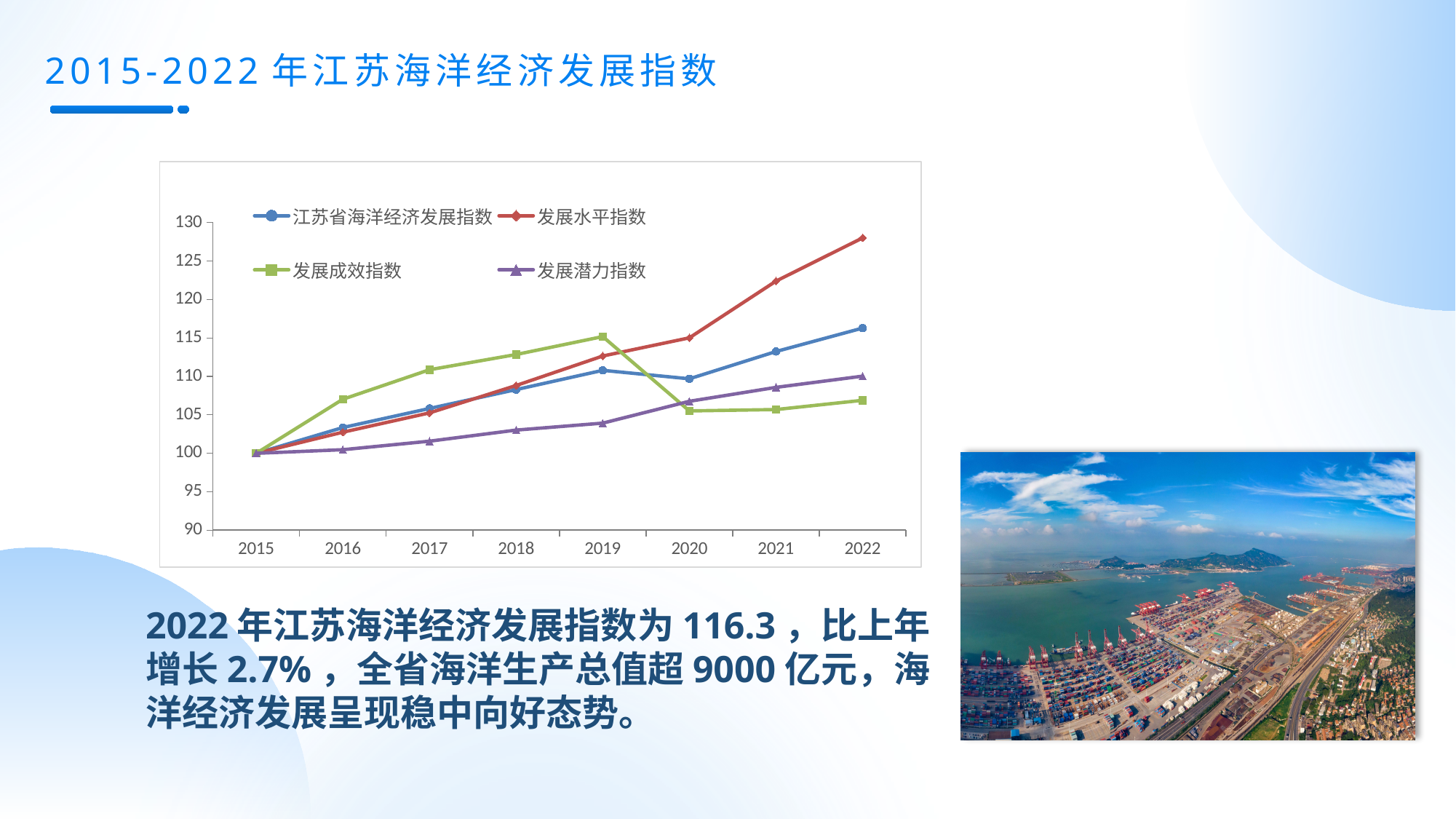
What is the value of all four indices in 2015? 100 In 2019, which is larger: 发展成效指数 or 发展水平指数? 发展成效指数 Is the value of 发展水平指数 in 2022 greater or less than 125? greater Which series has the lowest value in 2022? 发展成效指数 How many years are plotted along the x axis? 8 Is the value of 发展潜力指数 in 2017 greater or less than 105? less Does 发展水平指数 rise or fall from 2015 to 2022? rise How many series does the legend list? 4 What kind of chart is shown on the slide? line chart Is the value of 发展成效指数 in 2020 greater or less than 110? less What is the title of the slide containing the chart? 2015-2022年江苏海洋经济发展指数 Which series has the highest value in 2022? 发展水平指数